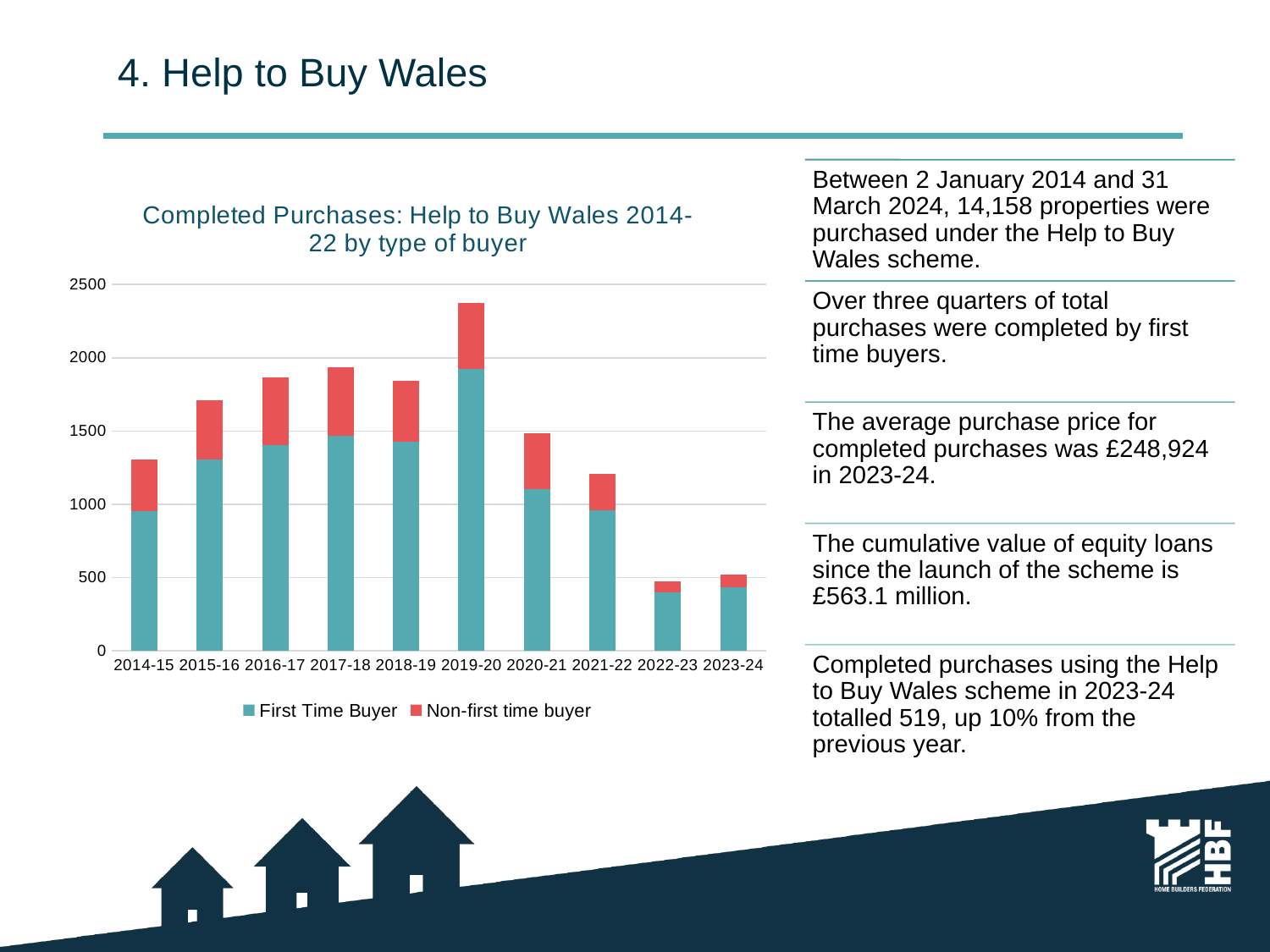
Which year has the highest total completed purchases in the chart? 2019-20 Is the total bar for 2019-20 greater or less than 2000? greater Which year has the larger total bar, 2017-18 or 2014-15? 2017-18 What kind of chart is shown on the slide? Stacked bar chart Do the total bars rise or fall from 2019-20 to 2022-23? fall How many years (categories) are shown on the x axis of the chart? 10 How many series does the chart legend list? 2 Is the total bar for 2022-23 greater or less than 1000? less Which series is shown in red in the chart? Non-first time buyer Is the First Time Buyer value for 2019-20 greater or less than 1500? greater